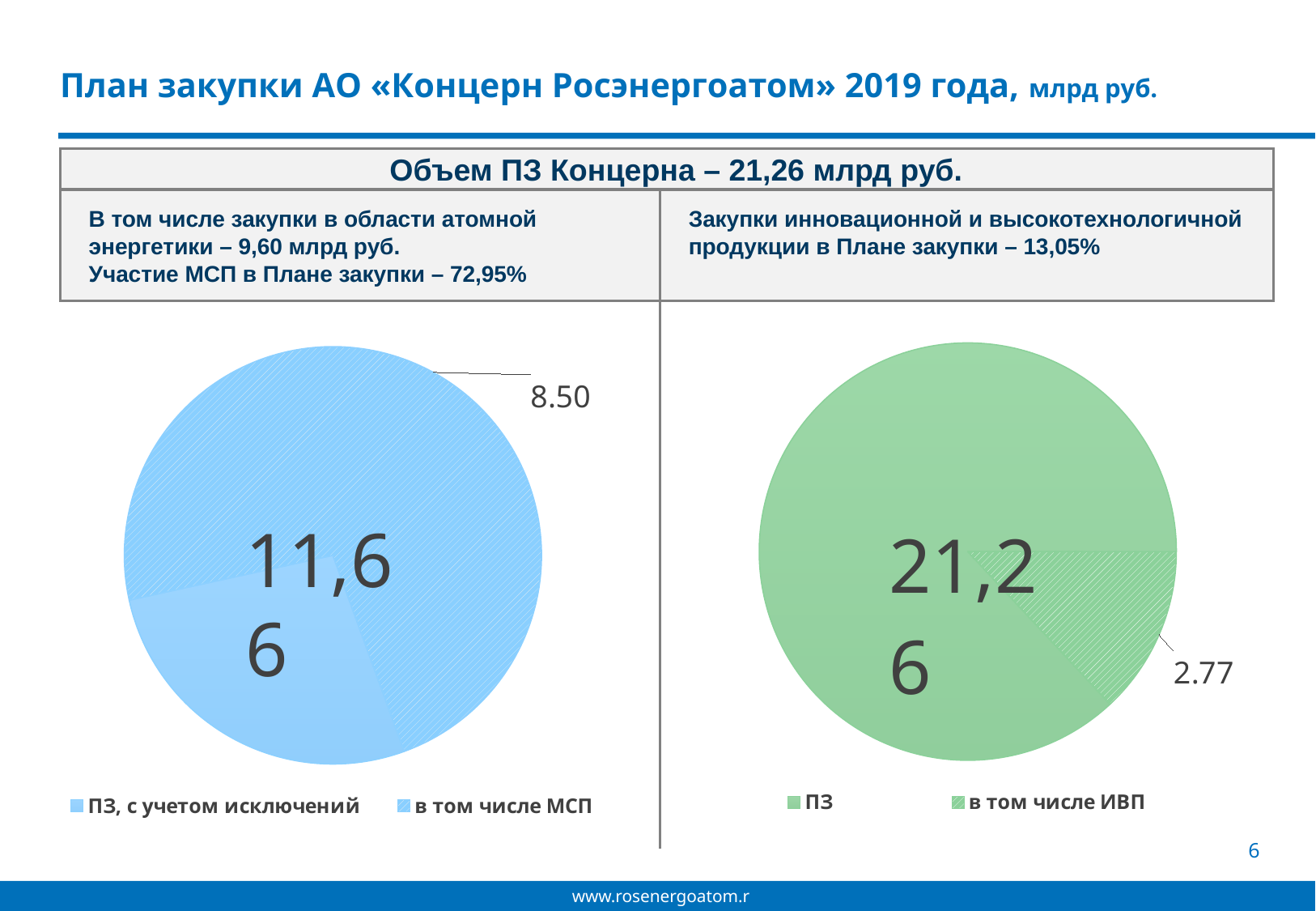
What type of chart is shown on the left side of the slide? pie chart In the left (blue) pie chart, what value is labelled for the hatched slice 'в том числе МСП'? 8.50 In the right (green) pie chart, which is larger: the value for 'ПЗ' or the value for 'в том числе ИВП'? ПЗ What type of chart is shown on the right side of the slide? pie chart What colour is the left pie chart on the slide? blue In the left (blue) pie chart, which is larger: the value for 'ПЗ, с учетом исключений' or the value for 'в том числе МСП'? в том числе МСП How many entries does the legend of the right (green) pie chart list? 2 Which legend entry in the right (green) pie chart corresponds to the hatched slice? в том числе ИВП In the right (green) pie chart, what value is labelled for the hatched slice 'в том числе ИВП'? 2.77 How many entries does the legend of the left (blue) pie chart list? 2